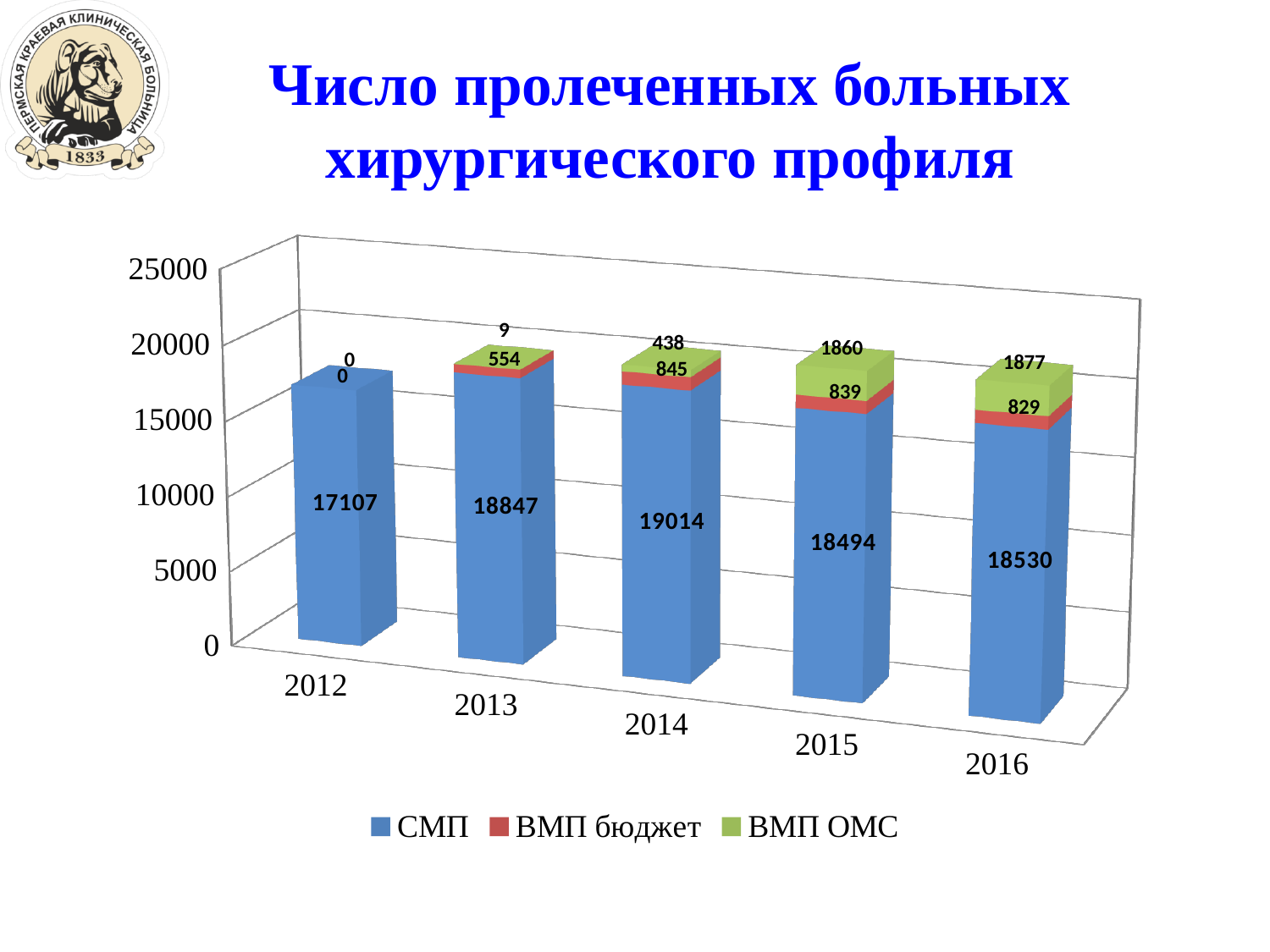
Which is larger, the ВМП ОМС value for 2016 or for 2015? 2016 What is the total of the stacked bar for 2016? 21236 What is the value of ВМП ОМС for 2015? 1860 How many series does the legend list? 3 What is the value of ВМП бюджет for 2013? 554 What kind of chart is shown on the slide? stacked bar chart What is the difference between the СМП values for 2013 and 2012? 1740 Is the СМП value for 2016 greater or less than 15000? greater What is the value of СМП for 2014? 19014 How many years are shown on the x axis? 5 Which year has the highest СМП value? 2014 Which year has the lowest СМП value? 2012